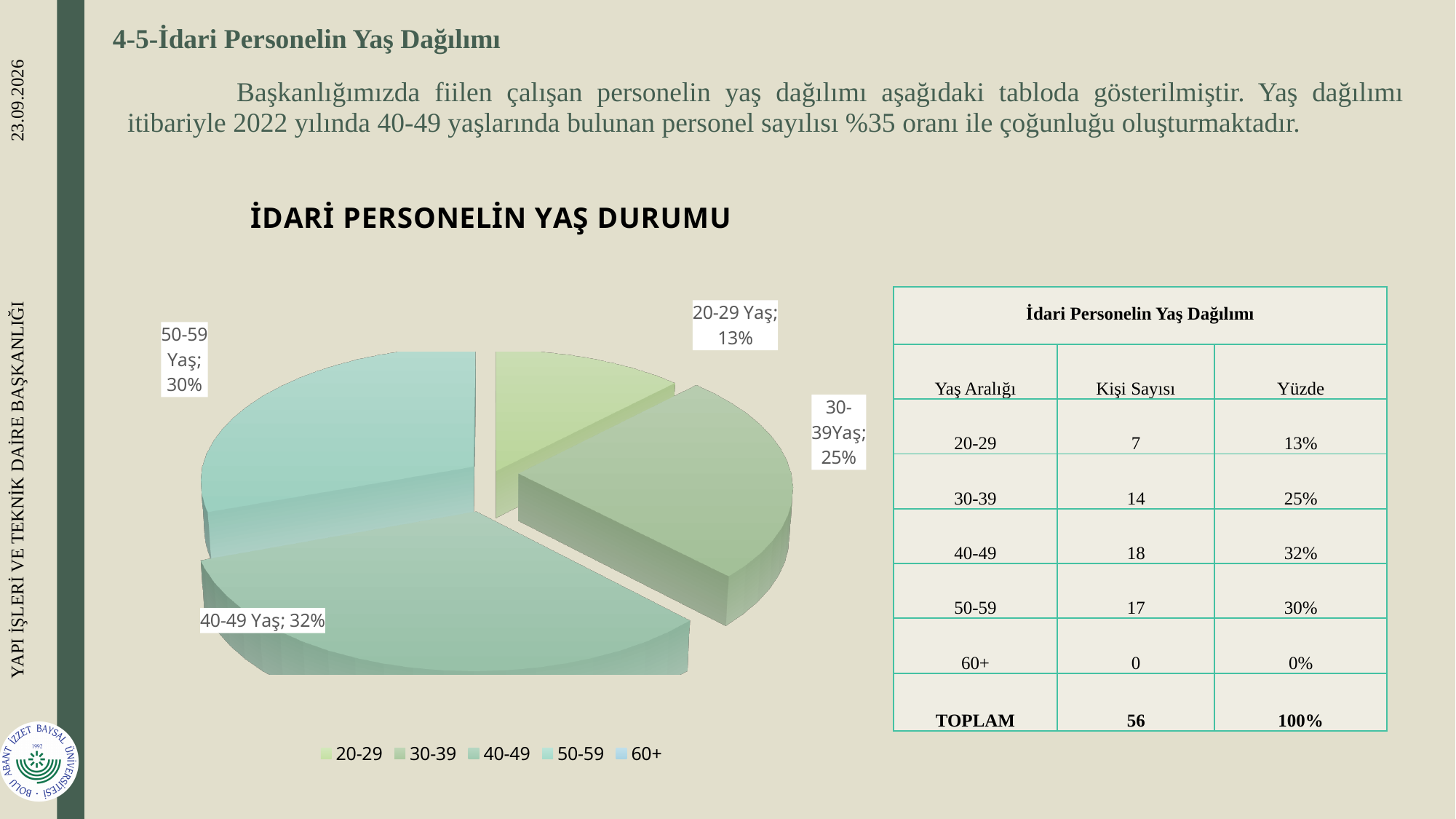
What percentage does the pie chart show for the 20-29 Yaş slice? 13% Which age group has the largest slice in the pie chart? 40-49 Yaş What type of chart is shown under the title "İDARİ PERSONELİN YAŞ DURUMU"? Pie chart What percentage does the pie chart show for the 50-59 Yaş slice? 30% In the pie chart, what is the difference in percentage points between the 30-39 Yaş slice and the 20-29 Yaş slice? 12 percentage points What percentage does the pie chart show for the 30-39 Yaş slice? 25% What percentage does the pie chart show for the 40-49 Yaş slice? 32% In the pie chart, which slice is larger: 30-39 Yaş or 50-59 Yaş? 50-59 Yaş What is the title of the pie chart? İDARİ PERSONELİN YAŞ DURUMU How many entries does the legend of the pie chart list? 5 In the pie chart, what is the difference in percentage points between the 40-49 Yaş slice and the 50-59 Yaş slice? 2 percentage points Which labelled age group has the smallest slice in the pie chart? 20-29 Yaş